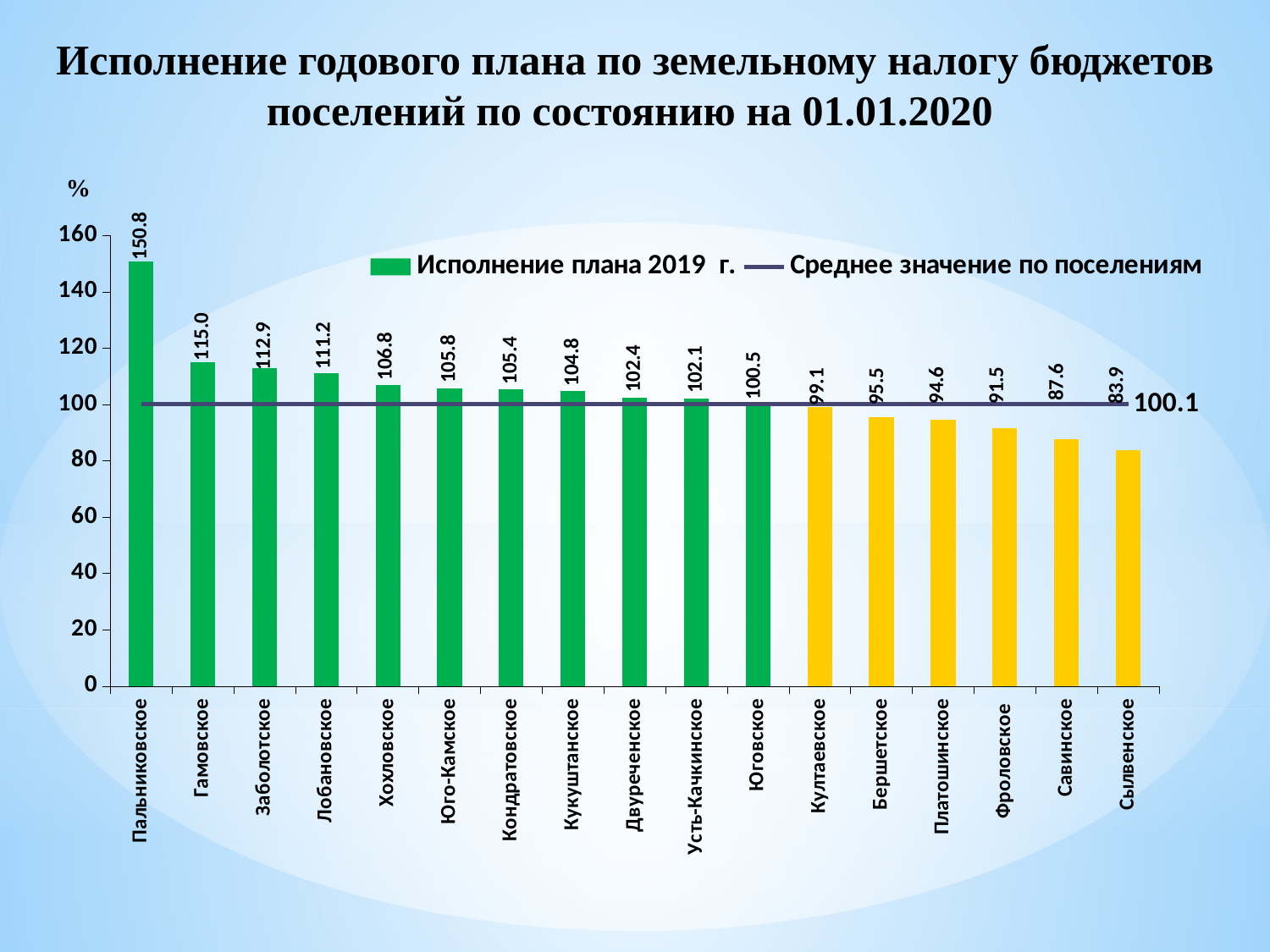
Which is larger, the value for Хохловское or the value for Бершетское? Хохловское Is the value for Савинское greater or less than 100? less What is the difference between the values for Гамовское and Заболотское? 2.1 What is the value for Фроловское? 91.5 Which settlement has the highest value? Пальниковское What kind of chart is this? bar chart What is the value of the average line (Среднее значение по поселениям)? 100.1 How many series does the legend list? 2 Which settlement has the lowest value? Сылвенское How many settlements are shown on the x axis? 17 What is the value for Пальниковское? 150.8 What is the value for Кондратовское? 105.4